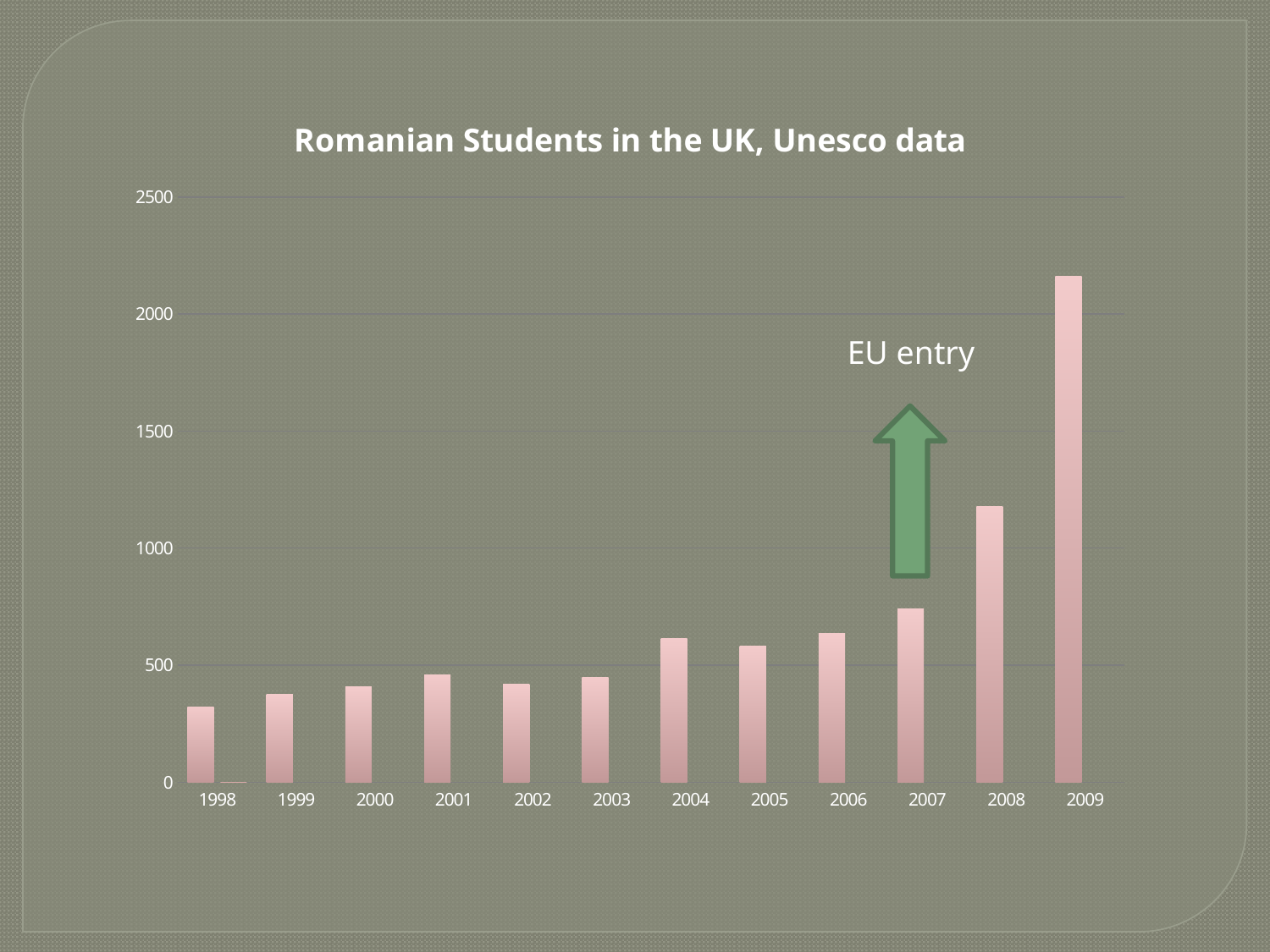
Which year has a larger value, 2007 or 2008? 2008 What kind of chart is shown on the slide? Bar chart Do the values generally rise or fall from 1998 to 2009? Rise Is the value for 2007 greater or less than 1000? less Is the value for 2008 greater or less than 1000? greater Is the value for 2004 greater or less than 500? greater What is the title of the chart? Romanian Students in the UK, Unesco data How many years are shown on the x axis of the chart? 12 Which year has the highest number of Romanian students in the UK? 2009 Which year has the lowest number of Romanian students in the UK? 1998